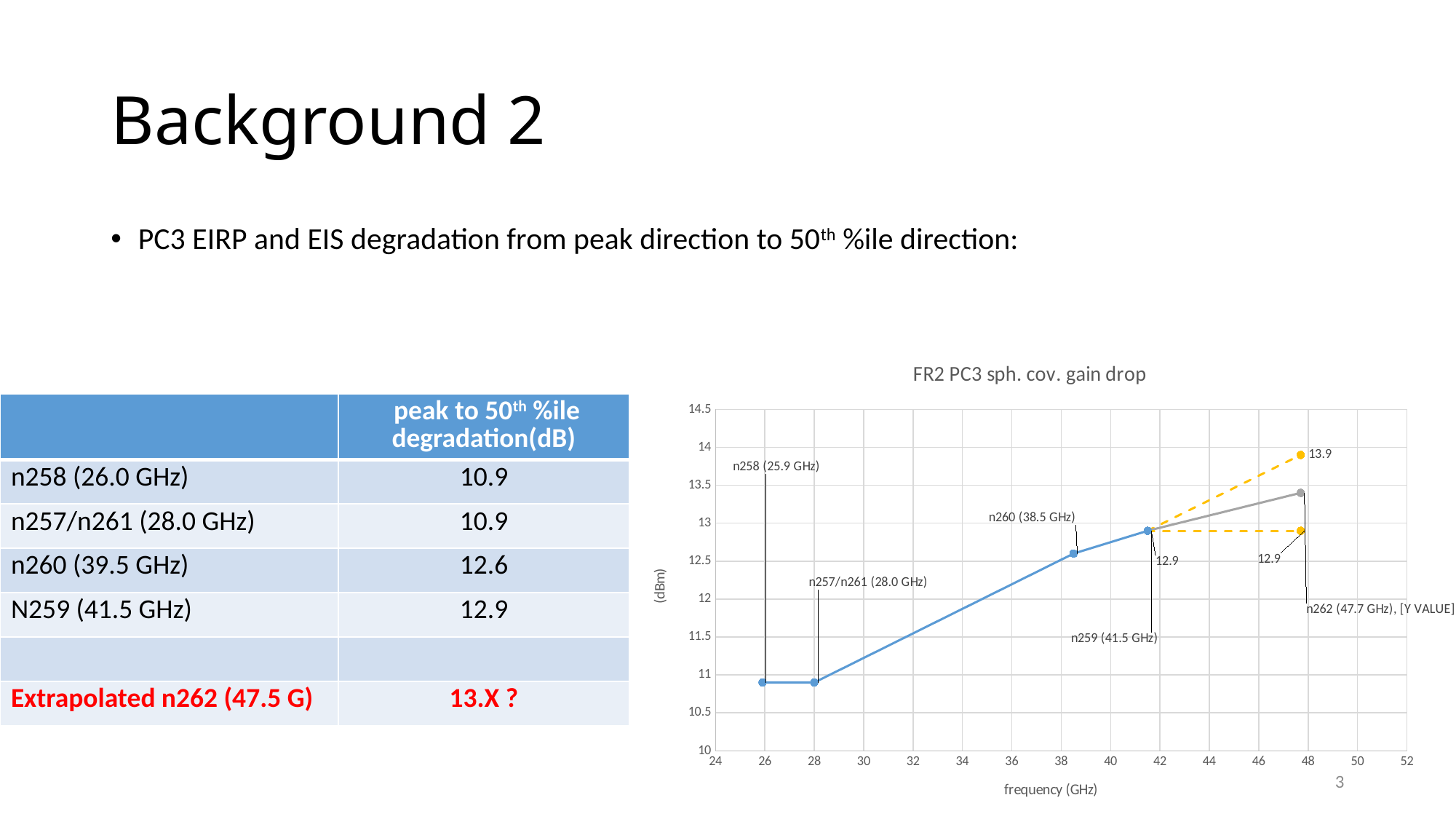
Do the values on the solid blue line rise or fall as frequency increases from 26 GHz to 41.5 GHz? rise What is the label of the x axis of the chart? frequency (GHz) What value is labelled at the n259 (41.5 GHz) point on the chart? 12.9 Is the value for n258 (25.9 GHz) greater or less than 11? less What is the difference between the upper (13.9) and lower (12.9) extrapolated values at 47.7 GHz? 1.0 How many data points are plotted on the solid blue line? 4 Is the value for n260 (38.5 GHz) greater or less than 12? greater What value is labelled at the lower dashed extrapolated point at 47.7 GHz? 12.9 Which has the larger value, n260 (38.5 GHz) or n259 (41.5 GHz)? n259 (41.5 GHz) What is the title of the chart? FR2 PC3 sph. cov. gain drop What type of chart is shown on the slide? line chart What value is labelled at the upper dashed extrapolated point at 47.7 GHz? 13.9